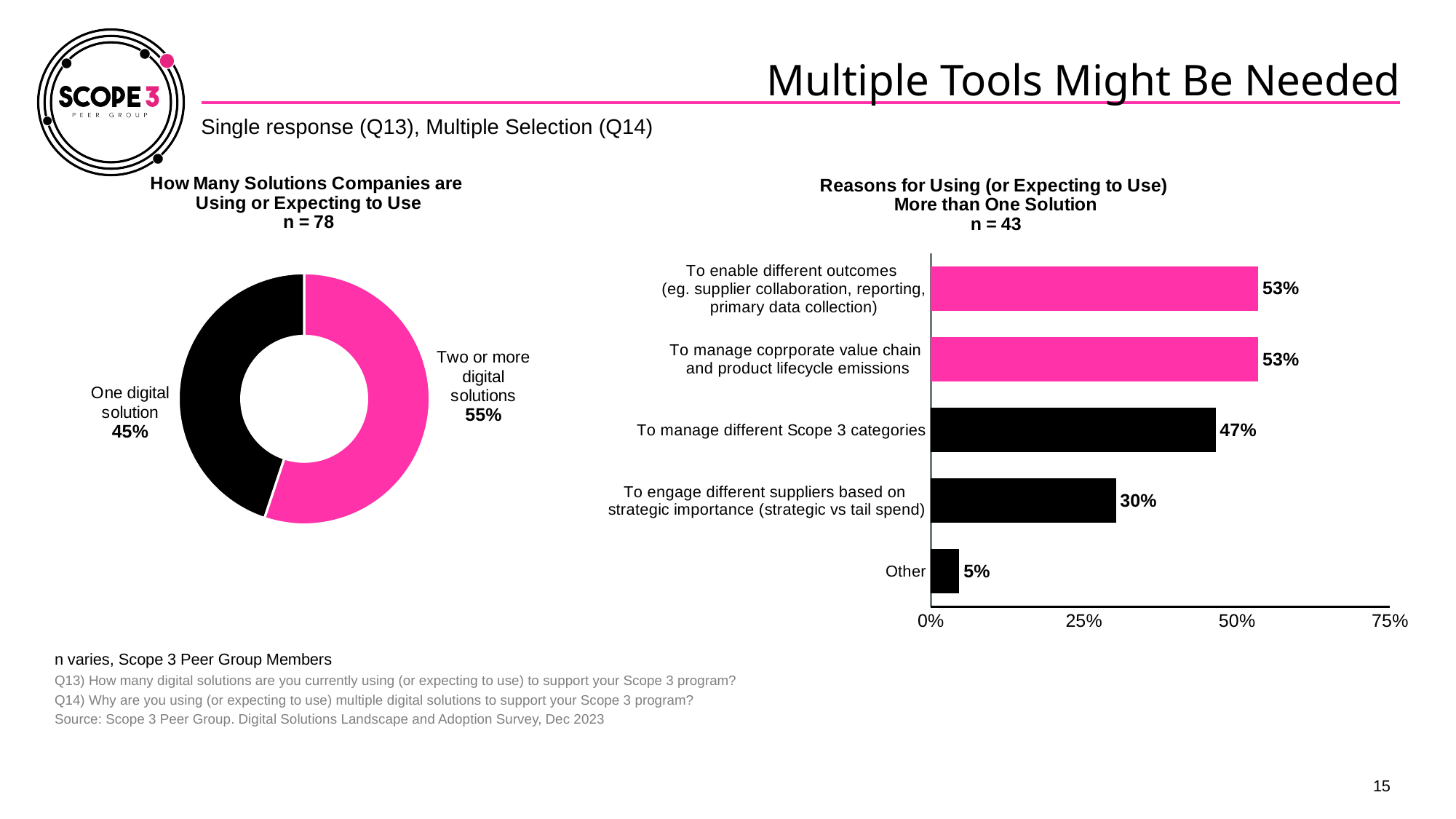
In the 'Reasons for Using (or Expecting to Use) More than One Solution' chart, how many categories are shown? 5 In the 'How Many Solutions Companies are Using or Expecting to Use' chart, what share of companies use one digital solution? 45% In the 'Reasons for Using (or Expecting to Use) More than One Solution' chart, what is the value for 'To engage different suppliers based on strategic importance (strategic vs tail spend)'? 30% In the 'How Many Solutions Companies are Using or Expecting to Use' chart, what share of companies use two or more digital solutions? 55% In the 'How Many Solutions Companies are Using or Expecting to Use' chart, which slice is larger: one digital solution or two or more digital solutions? Two or more digital solutions In the 'Reasons for Using (or Expecting to Use) More than One Solution' chart, what is the difference between 'To manage different Scope 3 categories' and 'Other'? 42% In the 'Reasons for Using (or Expecting to Use) More than One Solution' chart, which category has the lowest value? Other In the 'Reasons for Using (or Expecting to Use) More than One Solution' chart, is the value for 'To engage different suppliers based on strategic importance' greater or less than 25%? greater What is the sample size (n) shown for the 'Reasons for Using (or Expecting to Use) More than One Solution' chart? n = 43 What kind of chart is the 'Reasons for Using (or Expecting to Use) More than One Solution' chart? Bar chart In the 'Reasons for Using (or Expecting to Use) More than One Solution' chart, what is the value for 'To manage different Scope 3 categories'? 47% What kind of chart is the 'How Many Solutions Companies are Using or Expecting to Use' chart? Doughnut (pie) chart